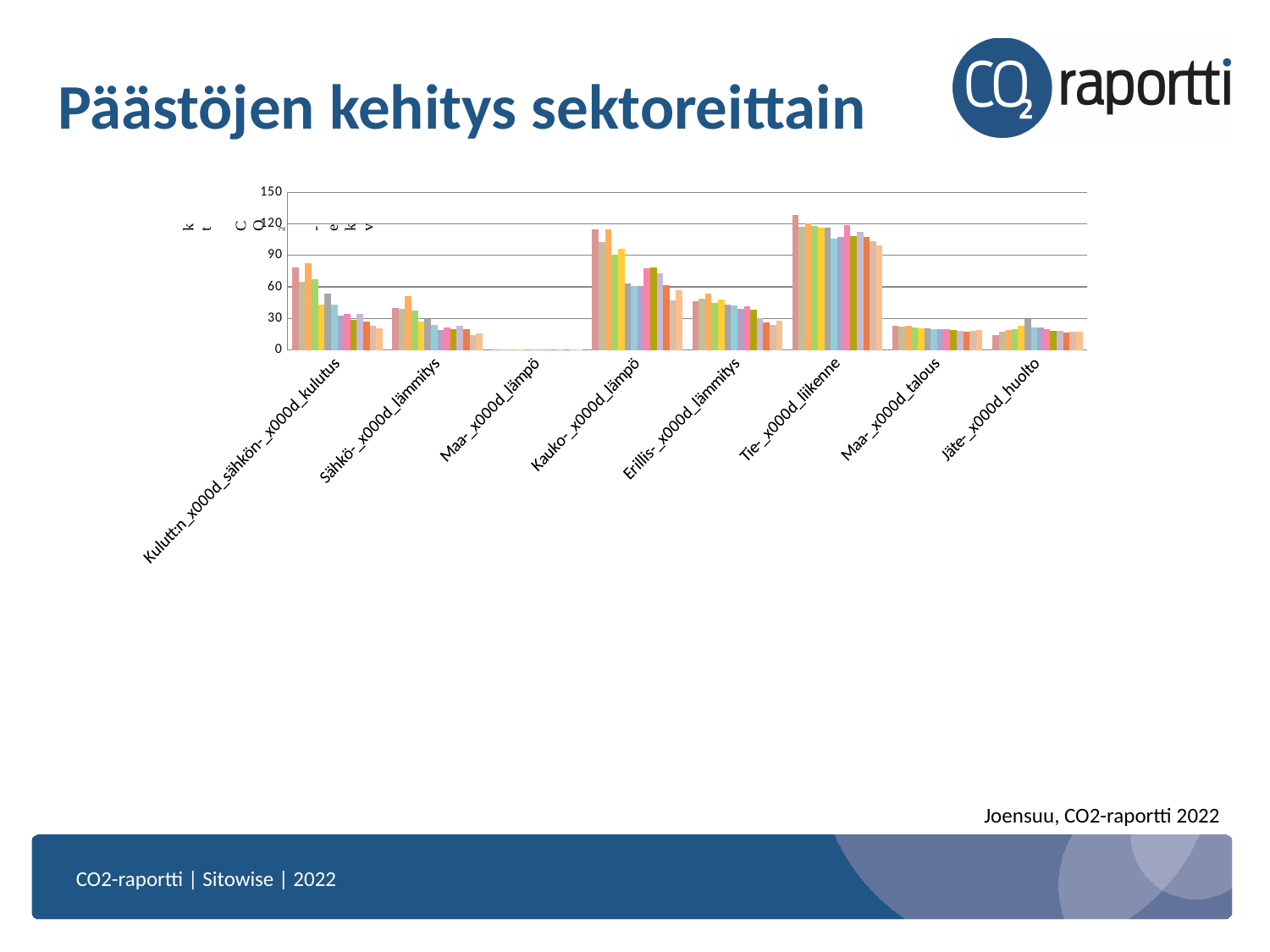
What is the maximum value shown on the y axis of the chart? 150 Are the values for Tie-liikenne greater or less than 90? greater Is the tallest bar for Kauko-lämpö greater or less than 90? greater Which category has the highest bars in the chart? Tie-liikenne What kind of chart is shown on the slide? bar chart Are the values for Maa-talous greater or less than 30? less Which category has taller bars, Kauko-lämpö or Erillis-lämmitys? Kauko-lämpö Which category has taller bars, Tie-liikenne or Maa-talous? Tie-liikenne How many categories are shown on the x axis of the chart? 8 Which category has the lowest bars in the chart? Maa-lämpö What is the title of the slide containing the chart? Päästöjen kehitys sektoreittain